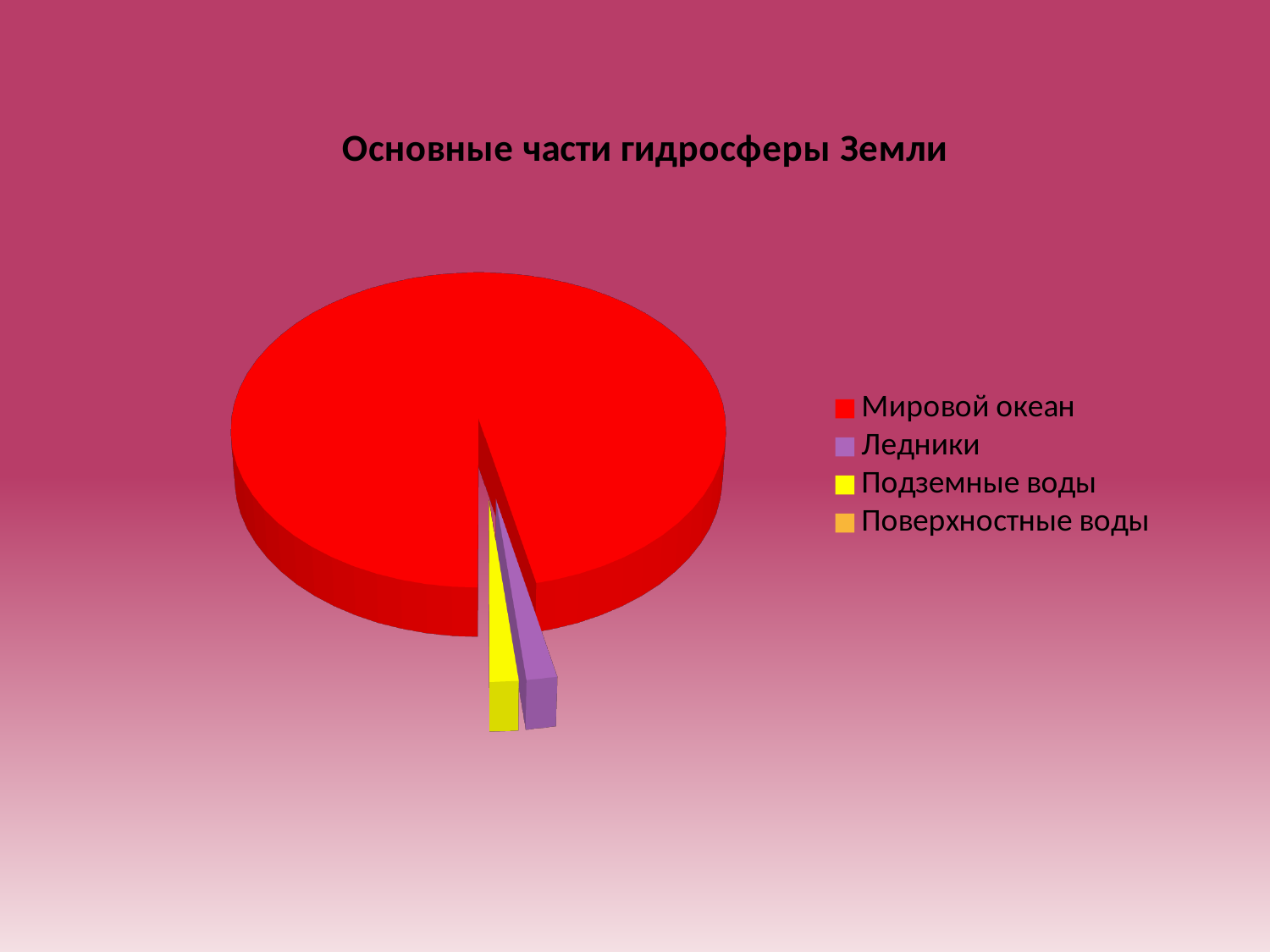
What kind of chart is shown on the slide? pie chart Does the slice for Мировой океан take up more or less than half of the pie? more Which colour represents Ледники in the chart? purple Which category has the largest slice of the pie? Мировой океан Which is larger, the slice for Мировой океан or the slice for Ледники? Мировой океан What is the title of the chart? Основные части гидросферы Земли How many categories does the legend of the chart list? 4 Which is larger, the slice for Мировой океан or the slice for Подземные воды? Мировой океан